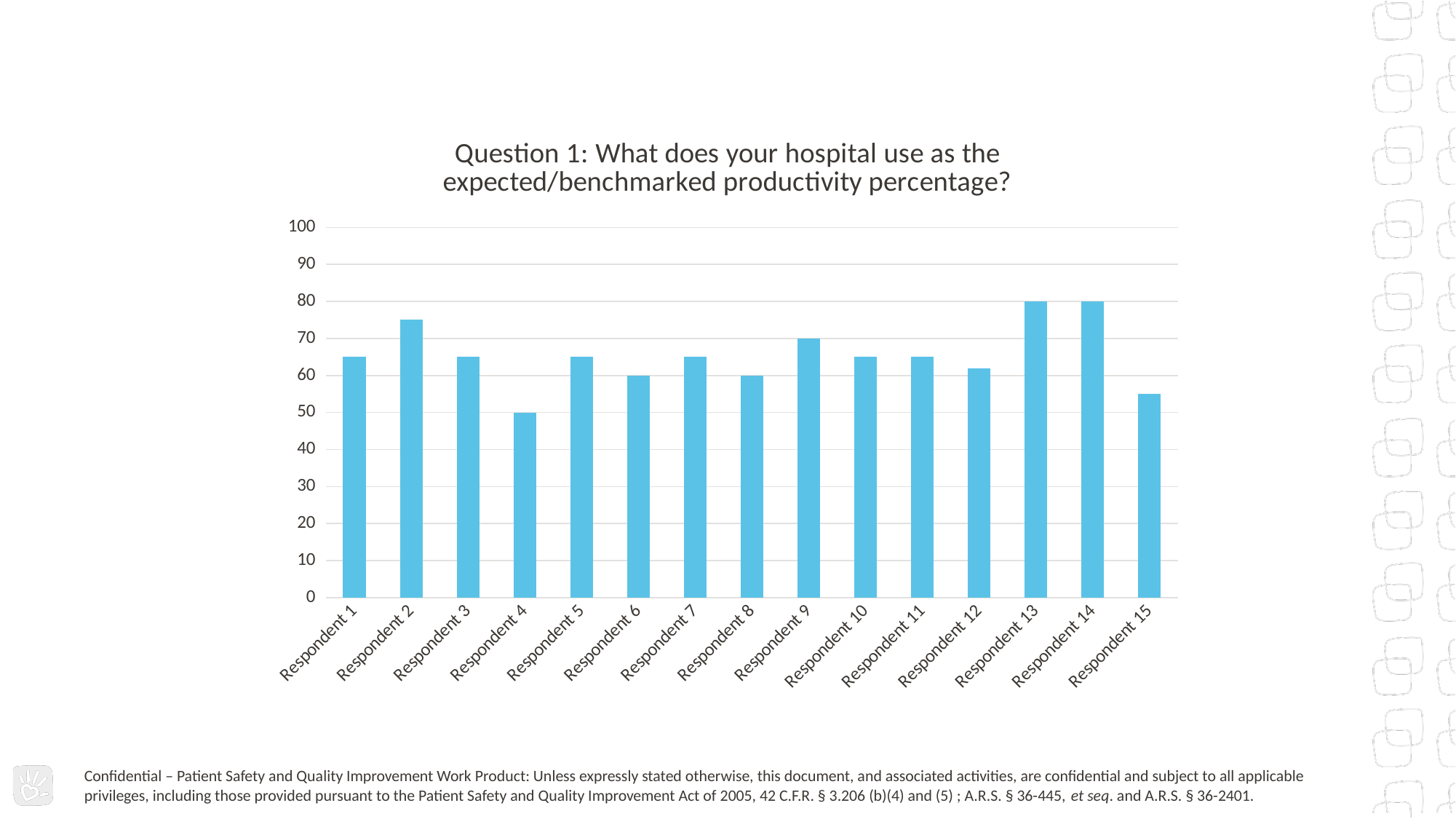
What is the value for Respondent 6? 60 Which respondent has the lowest value in the chart? Respondent 4 What is the difference between the values for Respondent 13 and Respondent 4? 30 What is the value for Respondent 4? 50 Is the value for Respondent 2 greater or less than 70? greater What is the value for Respondent 9? 70 What type of chart is shown on the slide? bar chart Which is larger, the value for Respondent 2 or the value for Respondent 4? Respondent 2 Is the value for Respondent 15 greater or less than 60? less What is the title of the chart? Question 1: What does your hospital use as the expected/benchmarked productivity percentage? How many respondents are shown on the x axis of the chart? 15 What is the value for Respondent 13? 80